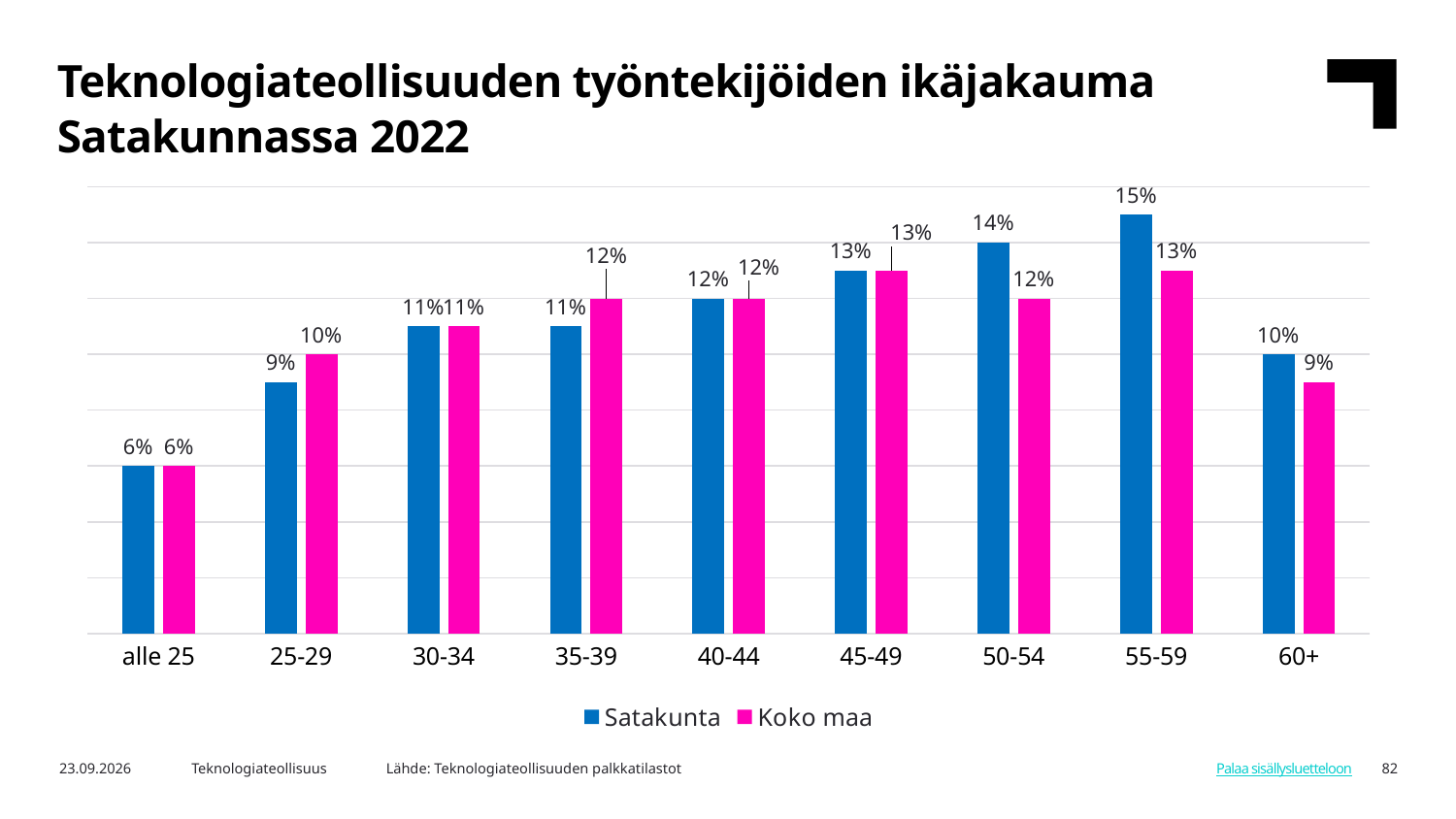
Which age group has the highest Satakunta value? 55-59 What kind of chart is shown on the slide? Bar chart What is the Koko maa value for the 25-29 age group? 10% How many series does the legend list? 2 For the 50-54 age group, which is larger: the Satakunta value or the Koko maa value? Satakunta What is the difference between the Satakunta and Koko maa values for the 55-59 age group? 2% What is the Satakunta value for the 50-54 age group? 14% What is the Koko maa value for the 60+ age group? 9% Which series is shown in pink in the legend? Koko maa Which age group has the lowest Koko maa value? alle 25 How many age groups are shown on the x axis? 9 What is the Satakunta value for the 55-59 age group? 15%